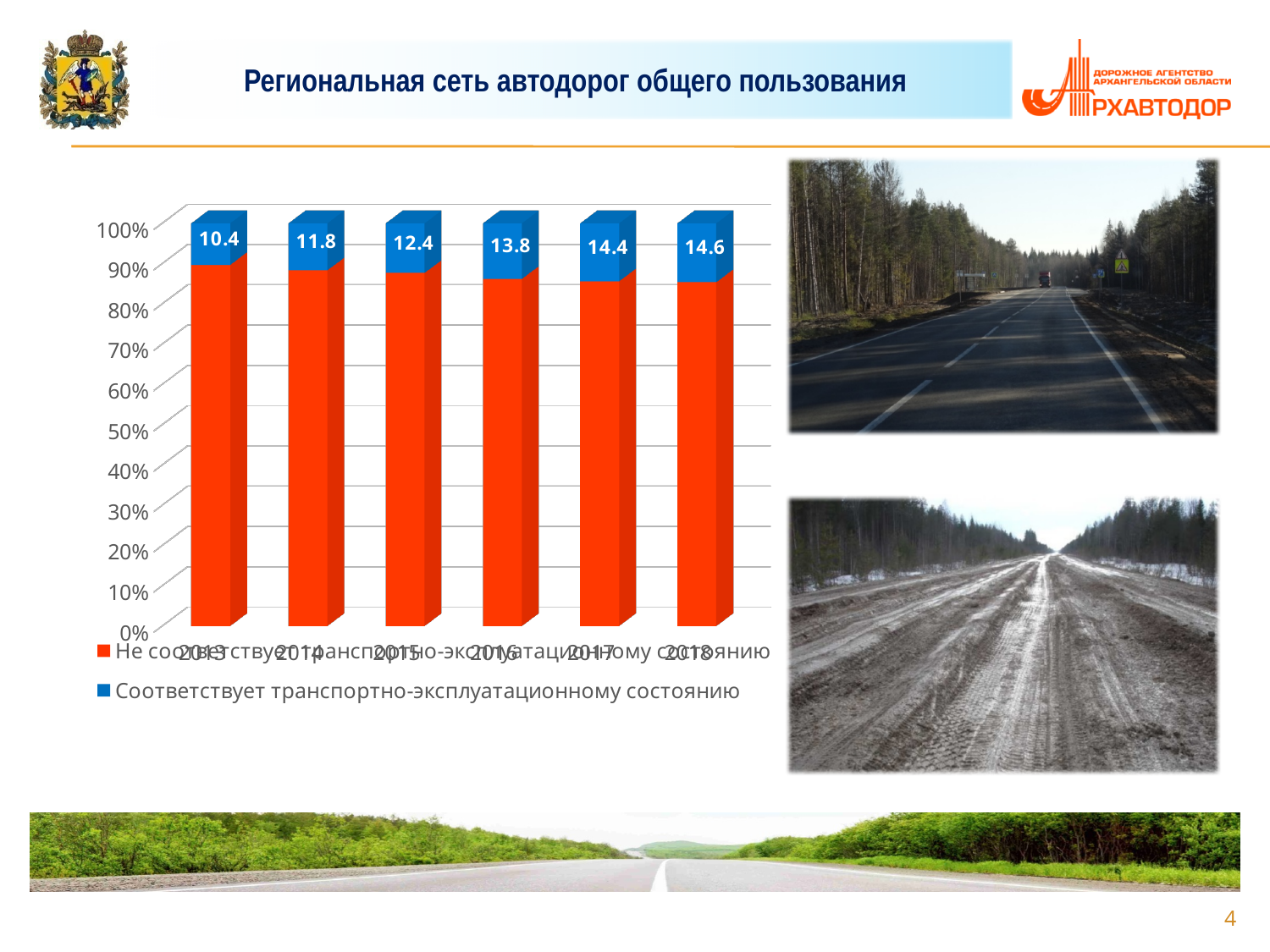
How many series does the legend list? 2 How many years are shown on the x axis of the chart? 6 Is the red (Не соответствует) portion of the 2013 bar greater or less than 80%? greater What is the value of the blue series (Соответствует транспортно-эксплуатационному состоянию) for 2016? 13.8 Do the labelled blue series values rise or fall from 2013 to 2018? rise What kind of chart is shown on the slide? stacked bar chart What is the difference between the blue series values for 2018 and 2013? 4.2 What is the value of the blue series (Соответствует транспортно-эксплуатационному состоянию) for 2018? 14.6 Which year has a larger blue series value, 2015 or 2017? 2017 In which year is the labelled blue series value the lowest? 2013 In which year is the labelled blue series value the highest? 2018 What is the value of the blue series (Соответствует транспортно-эксплуатационному состоянию) for 2013? 10.4